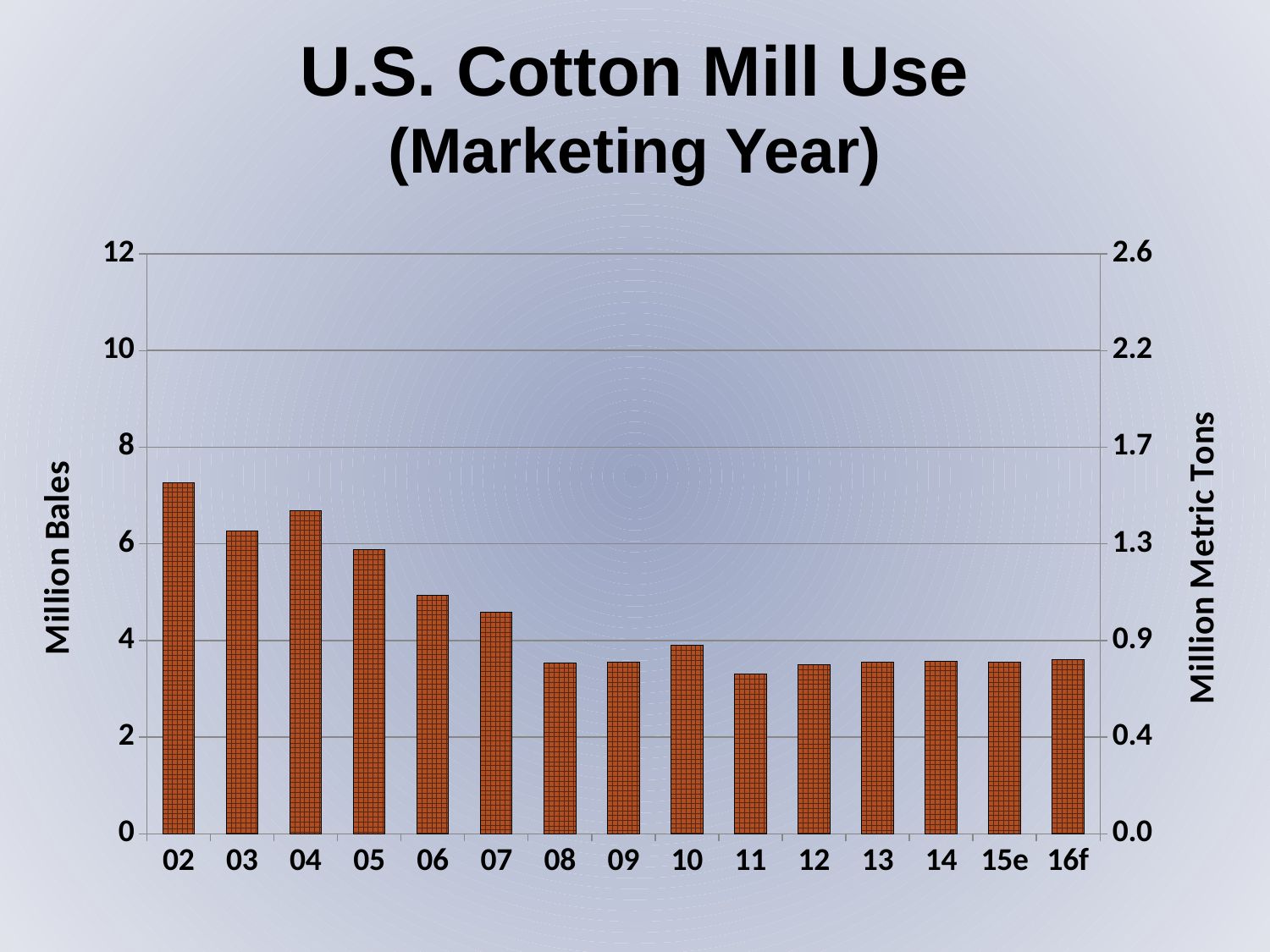
Is the value for 02 greater or less than 6 million bales? greater What kind of chart is shown on the slide? bar chart What is the label on the left vertical axis? Million Bales Overall, do the values rise or fall from 02 to 16f? fall Is the value for 08 greater or less than 4 million bales? less Which marketing year has the lowest cotton mill use? 11 Is the value for 07 greater or less than 4 million bales? greater Which is larger, the value for 03 or the value for 04? 04 Which marketing year has the highest cotton mill use? 02 How many marketing years are plotted on the chart? 15 Which is larger, the value for 10 or the value for 11? 10